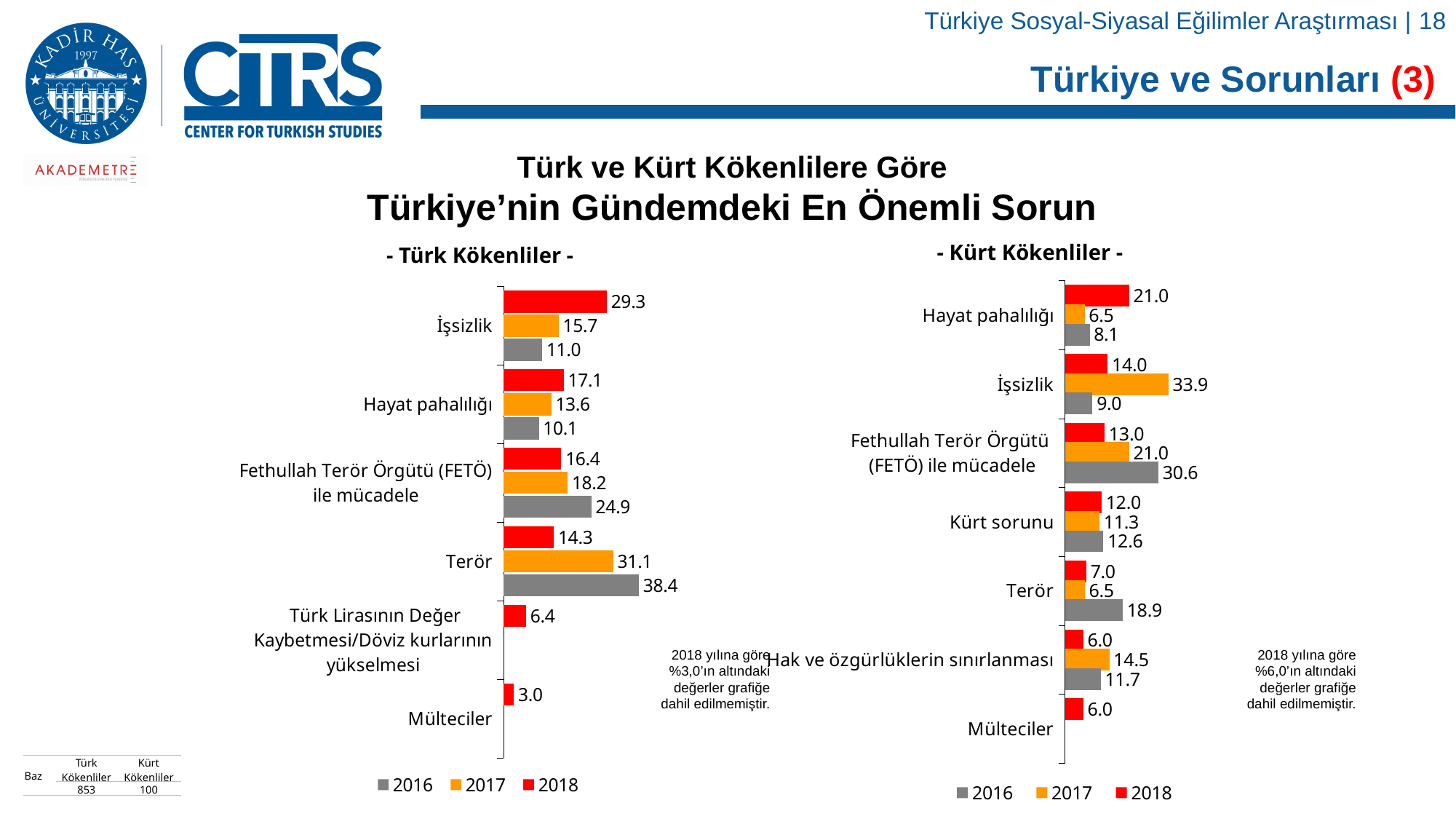
In the '- Türk Kökenliler -' chart, which category has the lowest 2018 value? Mülteciler In the '- Kürt Kökenliler -' chart, which is larger for Terör: the 2016 value or the 2018 value? 2016 In the '- Türk Kökenliler -' chart, which category has the highest 2016 value? Terör How many series does the legend of the '- Türk Kökenliler -' chart list? 3 In the '- Kürt Kökenliler -' chart, which category has the highest 2018 value? Hayat pahalılığı In the '- Kürt Kökenliler -' chart, what is the 2017 value for İşsizlik? 33.9 How many categories are shown in the '- Kürt Kökenliler -' chart? 7 In the '- Kürt Kökenliler -' chart, what is the difference between the 2016 and 2018 values for Fethullah Terör Örgütü (FETÖ) ile mücadele? 17.6 In the '- Türk Kökenliler -' chart, what is the difference between the 2016 and 2018 values for Terör? 24.1 What type of chart is the '- Türk Kökenliler -' chart? Bar chart In the '- Türk Kökenliler -' chart, what is the 2018 value for İşsizlik? 29.3 In the '- Türk Kökenliler -' chart, which colour represents the 2017 series? Orange